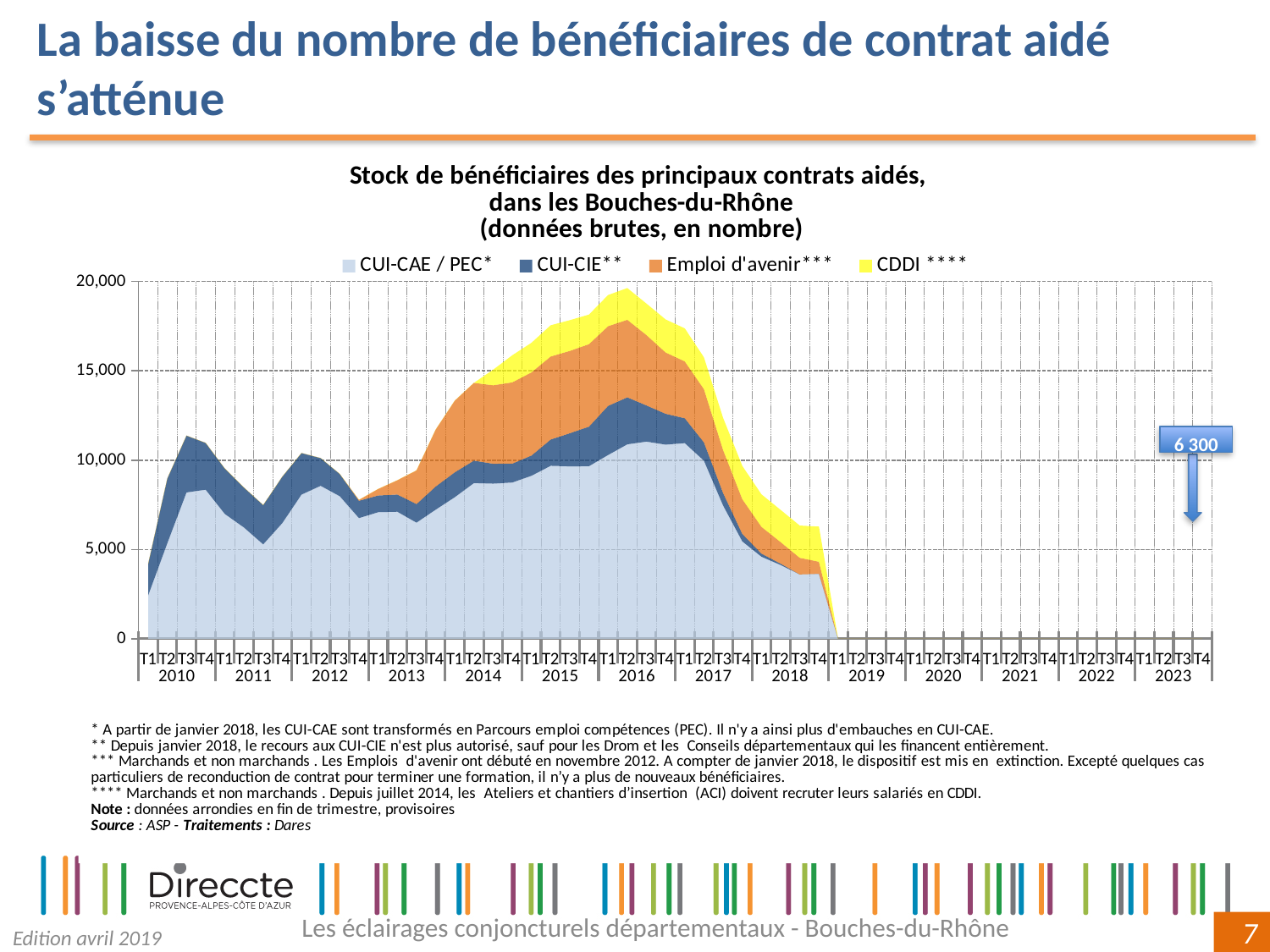
Is the total stock of beneficiaries in T4 2018 greater or less than 5,000? greater In which year does the total stock of beneficiaries reach its highest peak? 2016 Is the total stock of beneficiaries in T1 2014 greater or less than 10,000? greater Is the total stock of beneficiaries at the 2016 peak greater or less than 15,000? greater Which series is shown in yellow in the chart? CDDI **** Is the total stock of beneficiaries larger in T2 2016 or in T4 2018? T2 2016 What is the highest value shown on the vertical axis of the chart? 20,000 What value is printed in the blue callout box on the right side of the chart? 6 300 Does the total stock of beneficiaries rise or fall between 2016 and 2018? fall How many series does the chart legend list? 4 What kind of chart is shown on the slide? Stacked area chart